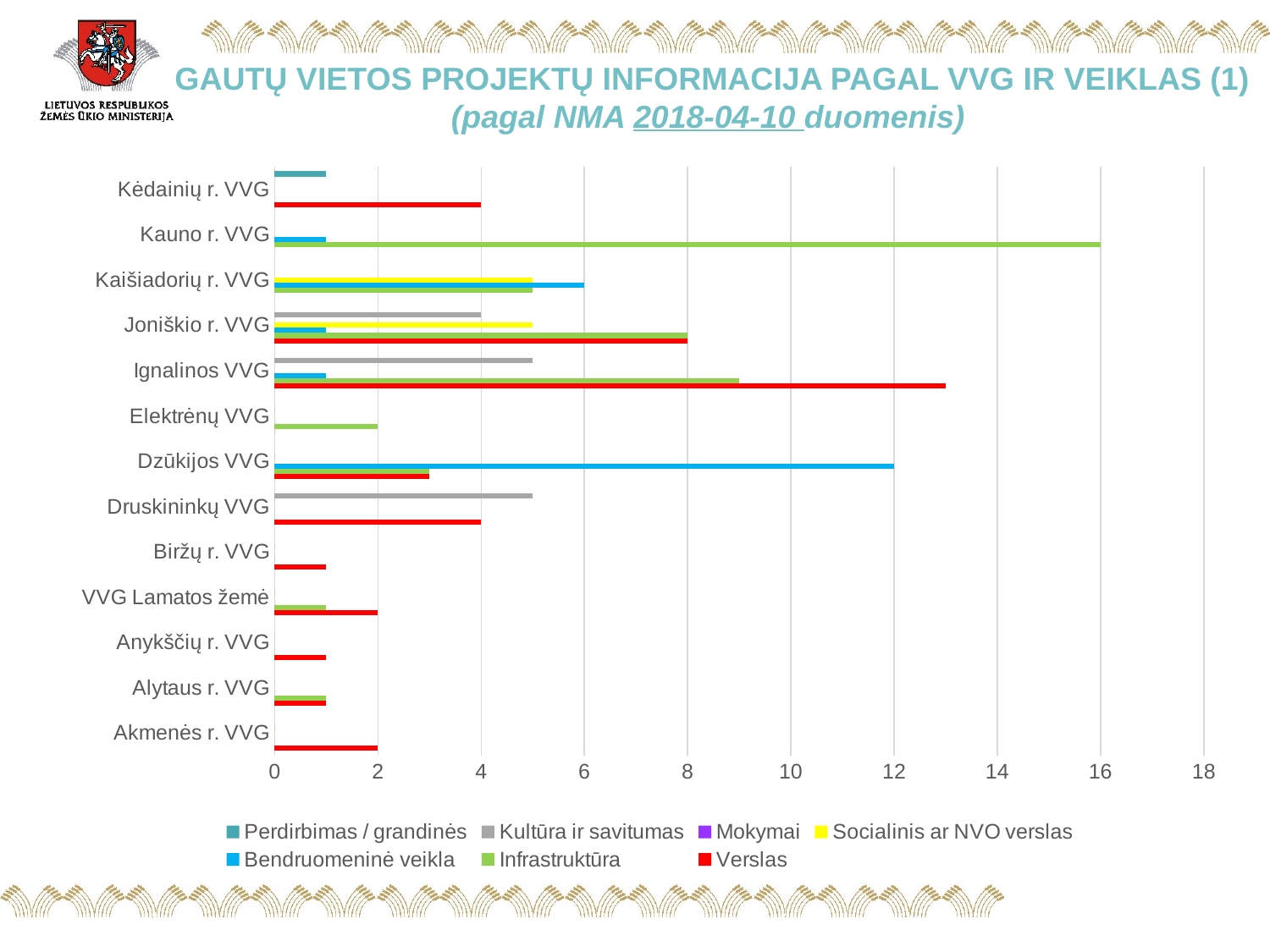
What is the difference between the Infrastruktūra value for Kauno r. VVG and the Bendruomeninė veikla value for Dzūkijos VVG? 4 What is the Bendruomeninė veikla value for Dzūkijos VVG? 12 What is the Verslas value for Kėdainių r. VVG? 4 How many series does the legend list? 7 What is the Infrastruktūra value for Kauno r. VVG? 16 Which is larger: the Verslas value for Kėdainių r. VVG or the Verslas value for Akmenės r. VVG? Kėdainių r. VVG What type of chart is shown on the slide? bar chart Which VVG has the highest Verslas value? Ignalinos VVG What is the Bendruomeninė veikla value for Kaišiadorių r. VVG? 6 How many VVG categories are listed on the vertical axis? 13 Is the Verslas value for Ignalinos VVG greater or less than 12? greater Which VVG has the highest Infrastruktūra value? Kauno r. VVG